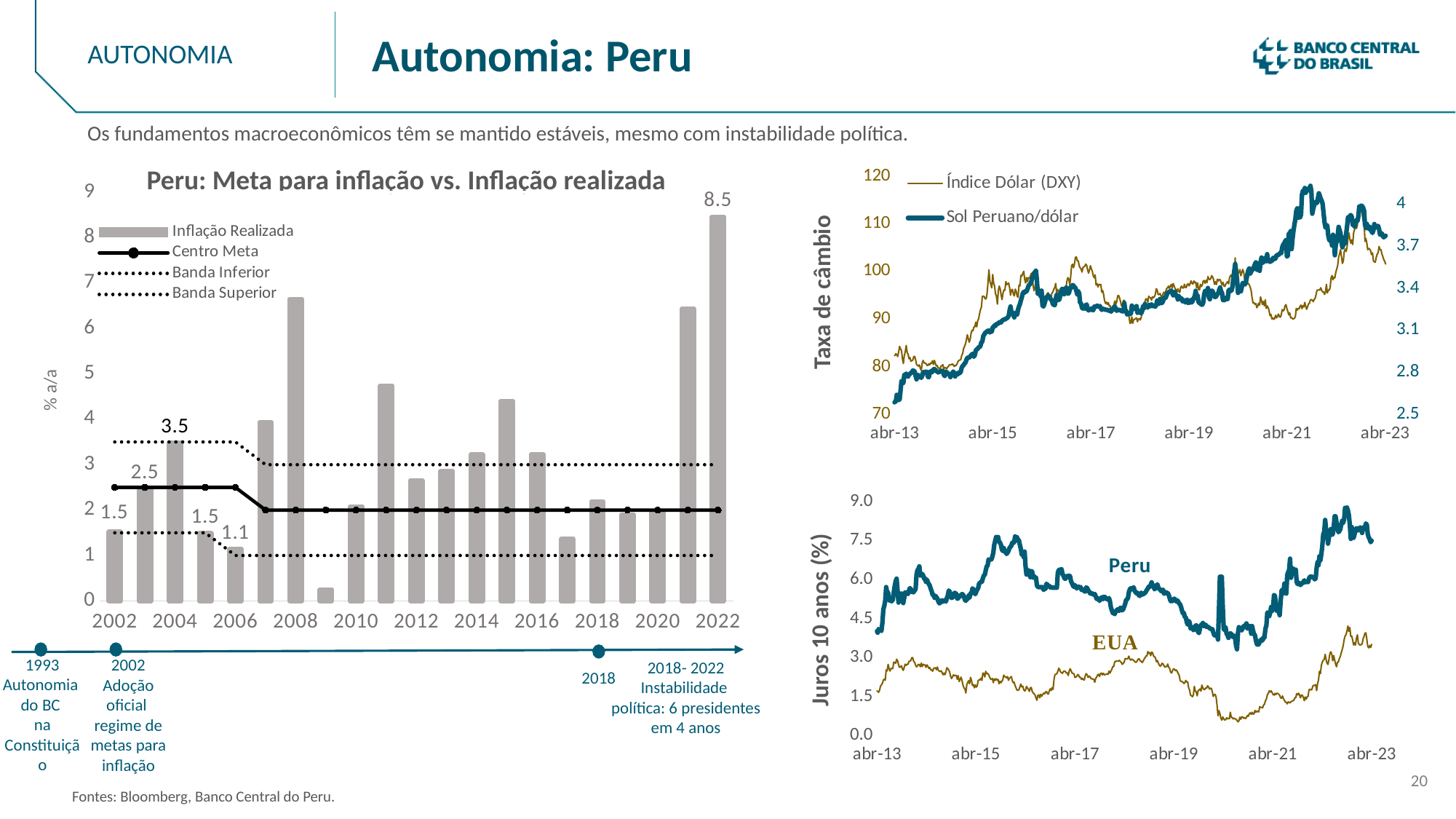
In the chart 'Peru: Meta para inflação vs. Inflação realizada', which year has the larger Inflação Realizada, 2003 or 2004? 2004 In the chart 'Peru: Meta para inflação vs. Inflação realizada', which year has the highest Inflação Realizada? 2022 In the chart 'Peru: Meta para inflação vs. Inflação realizada', what is the value of Inflação Realizada for 2022? 8.5 In the chart 'Peru: Meta para inflação vs. Inflação realizada', what is the value of Inflação Realizada for 2006? 1.1 In the chart 'Peru: Meta para inflação vs. Inflação realizada', what is the difference between the Inflação Realizada values for 2022 and 2002? 7.0 In the chart 'Peru: Meta para inflação vs. Inflação realizada', is the Inflação Realizada for 2009 greater or less than 1? less In the chart 'Peru: Meta para inflação vs. Inflação realizada', what is the value of Inflação Realizada for 2002? 1.5 How many series does the legend of the chart 'Peru: Meta para inflação vs. Inflação realizada' list? 4 In the chart 'Peru: Meta para inflação vs. Inflação realizada', is the Inflação Realizada for 2008 greater or less than 6? greater In the bottom-right chart (Juros 10 anos), which series is higher at abr-23, Peru or EUA? Peru How many series does the legend of the top-right chart (Taxa de câmbio) list? 2 In the chart 'Peru: Meta para inflação vs. Inflação realizada', how many years are shown on the x axis with bars? 21